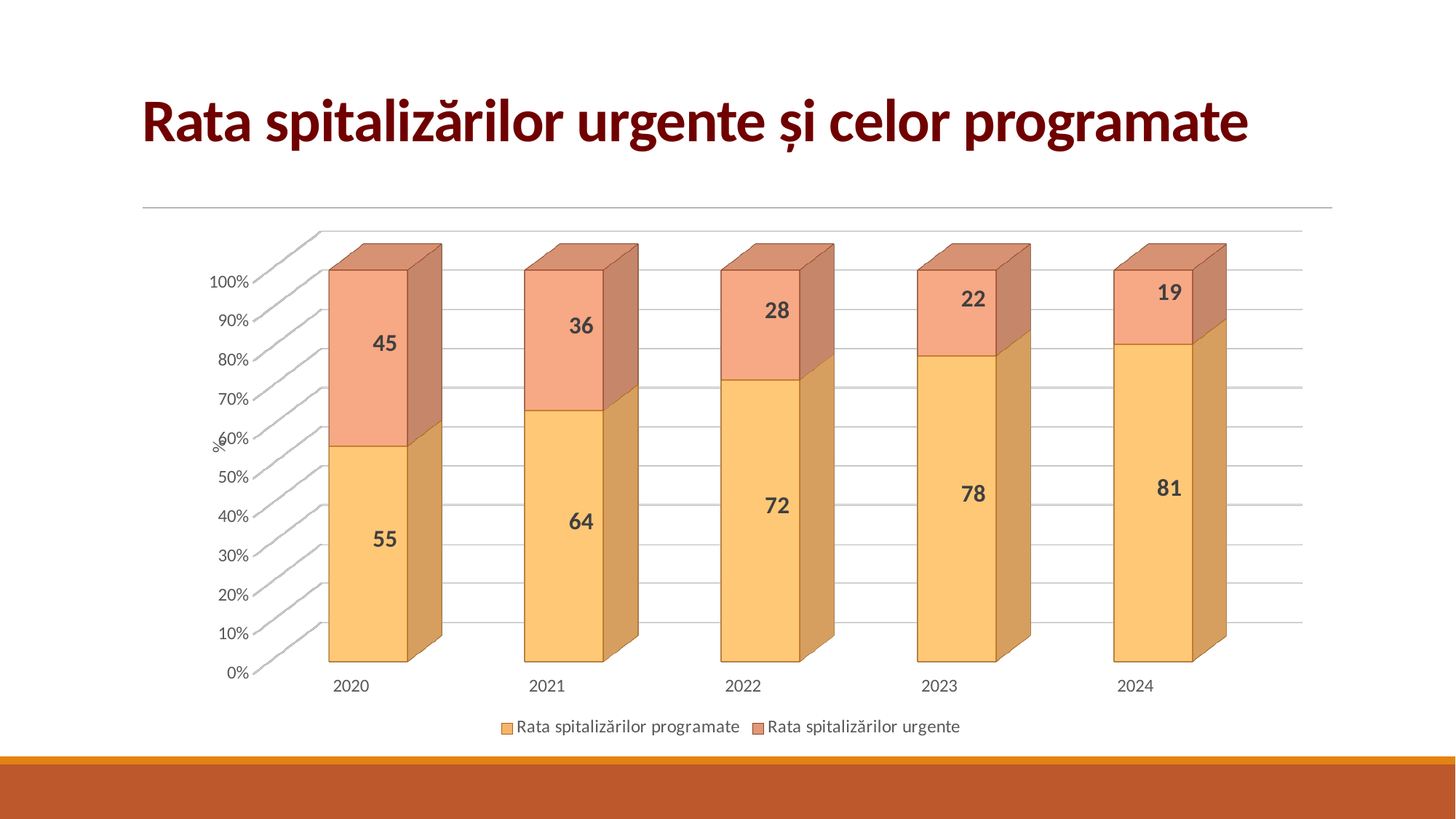
How many series does the legend list? 2 What is the value for Rata spitalizărilor programate in 2020? 55 Does Rata spitalizărilor urgente rise or fall from 2020 to 2024? Fall What is the value for Rata spitalizărilor urgente in 2022? 28 What is the title of the chart? Rata spitalizărilor urgente și celor programate What is the value for Rata spitalizărilor urgente in 2024? 19 How many years are shown on the x axis? 5 In which year is Rata spitalizărilor urgente lowest? 2024 Which is larger in 2021: Rata spitalizărilor programate or Rata spitalizărilor urgente? Rata spitalizărilor programate What kind of chart is shown on the slide? Stacked bar chart In which year is Rata spitalizărilor programate highest? 2024 What is the difference between Rata spitalizărilor programate in 2024 and in 2020? 26